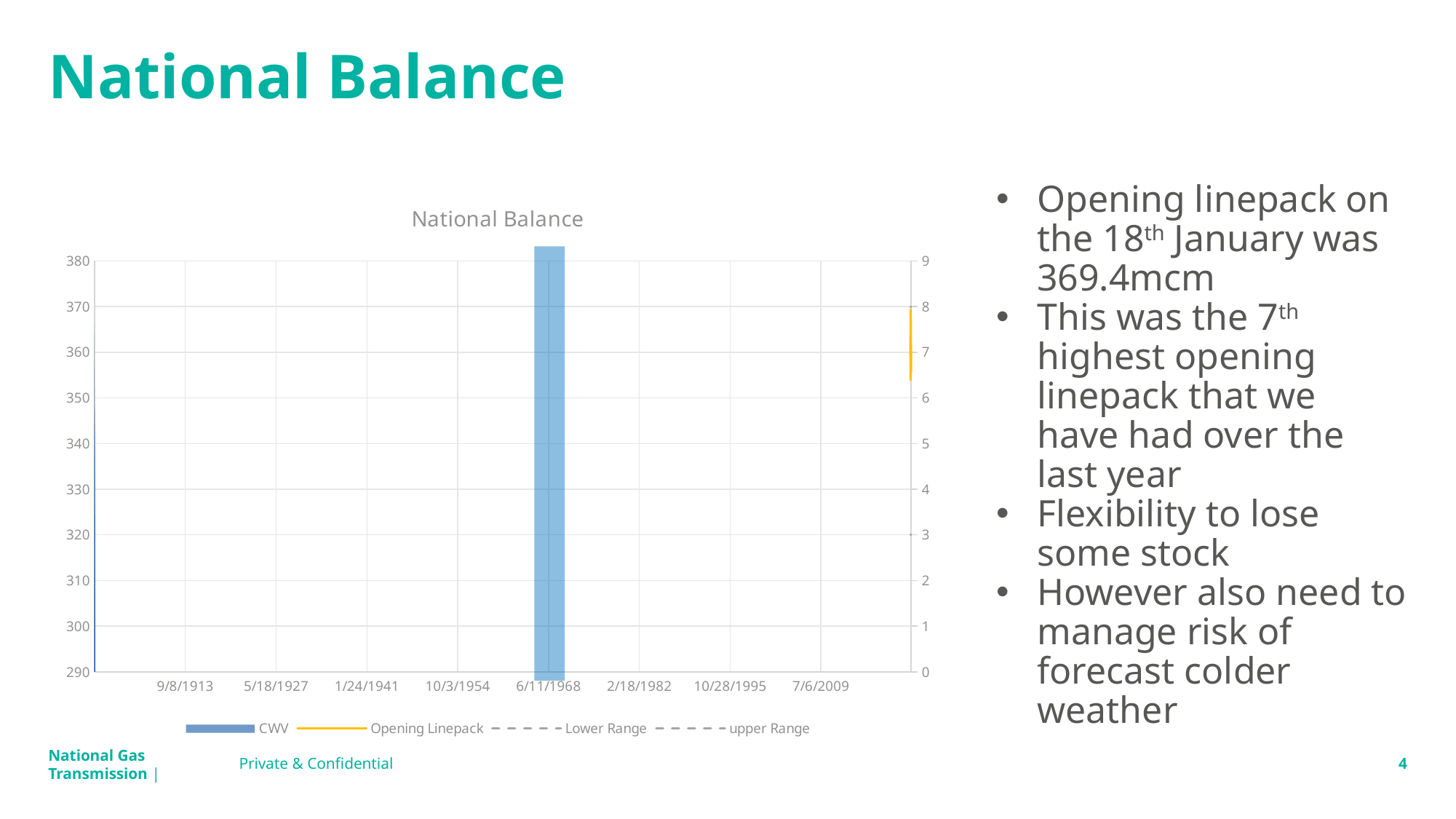
At which x-axis date label does the blue CWV bar appear? 6/11/1968 Which series in the legend is drawn as a bar? CWV What is the title of the chart? National Balance How many series does the chart legend list? 4 Does the blue CWV bar extend above or below the 380 tick on the left axis? above What kind of chart is shown on the slide? A combined bar and line chart How many date labels are shown along the x axis? 8